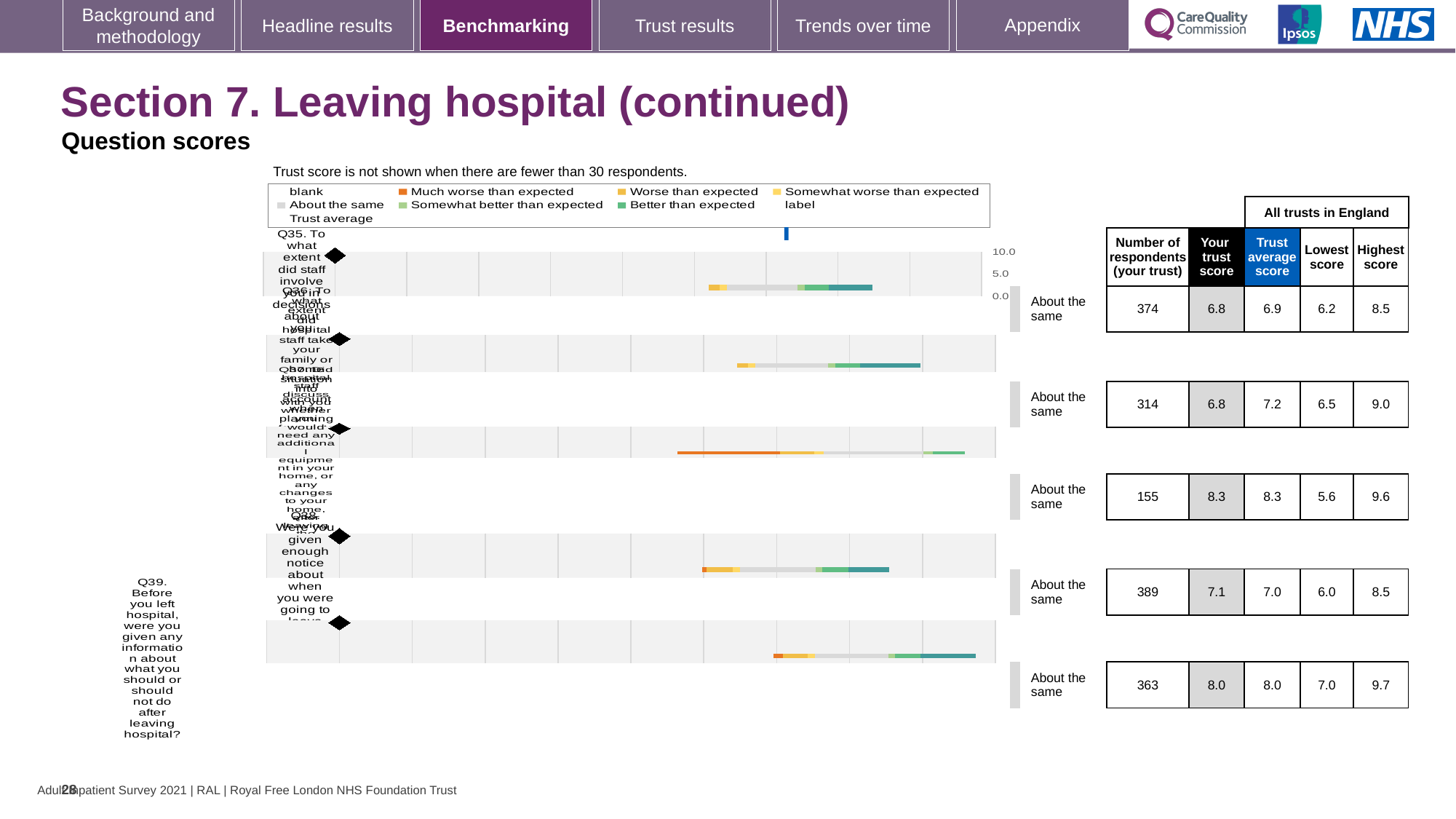
How many respondents (your trust) are shown for Q37? 155 What is the trust average score for Q39? 8.0 For Q38, which is larger: your trust score or the trust average score? Your trust score Which question has the highest 'Highest score' value in the table? Q39 What is the difference between the trust average score and your trust score for Q36? 0.4 Which question has the largest number of respondents (your trust)? Q38 How many respondents (your trust) are shown for Q38? 389 What benchmark category is shown for Q37? About the same How many questions (rows) are shown in the chart? 5 What kind of chart is used to show the question scores? Bar chart What is the 'Your trust score' value for Q35? 6.8 Which question has the lowest 'Lowest score' value in the table? Q37